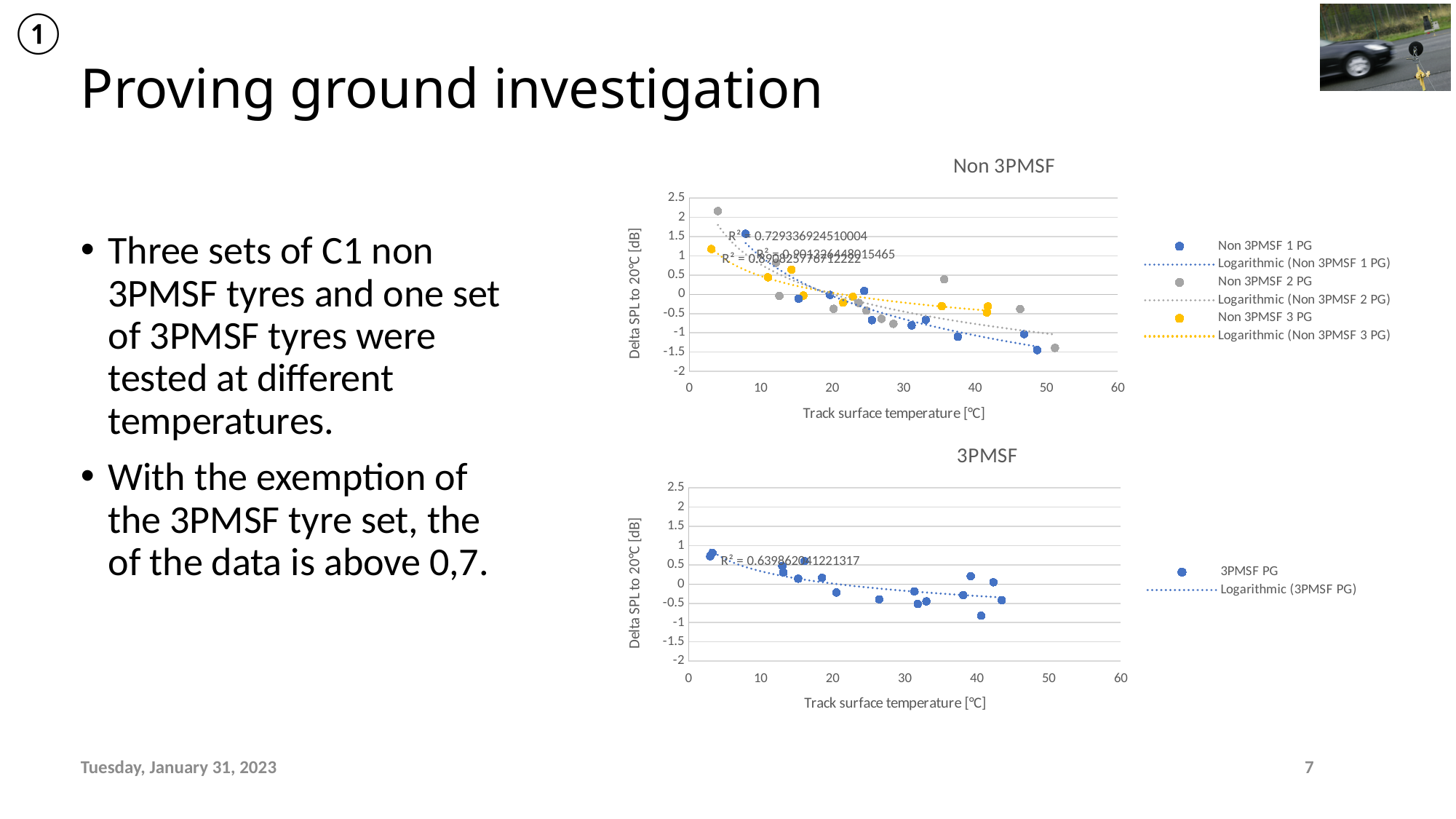
What colour are the 'Non 3PMSF 3 PG' points in the 'Non 3PMSF' chart? yellow What is the x-axis title of the '3PMSF' chart? Track surface temperature [°C] What R² value is shown for the logarithmic trendline in the '3PMSF' chart? 0.639862041221317 How many entries does the legend of the '3PMSF' chart list? 2 In the '3PMSF' chart, is the lowest plotted point (near 40 °C) greater or less than -0.5 dB? less In the '3PMSF' chart, do the Delta SPL values generally rise or fall as track surface temperature increases? fall How many entries does the legend of the 'Non 3PMSF' chart list? 6 What is the first R² value printed in the 'Non 3PMSF' chart (the one next to the blue series)? 0.729336924510004 What kind of chart is the '3PMSF' chart? scatter chart What kind of chart is the 'Non 3PMSF' chart? scatter chart In the 'Non 3PMSF' chart, is the highest grey 'Non 3PMSF 2 PG' point (near 4 °C) greater or less than 2 dB? greater In the 'Non 3PMSF' chart, do the Delta SPL values generally rise or fall as track surface temperature increases? fall